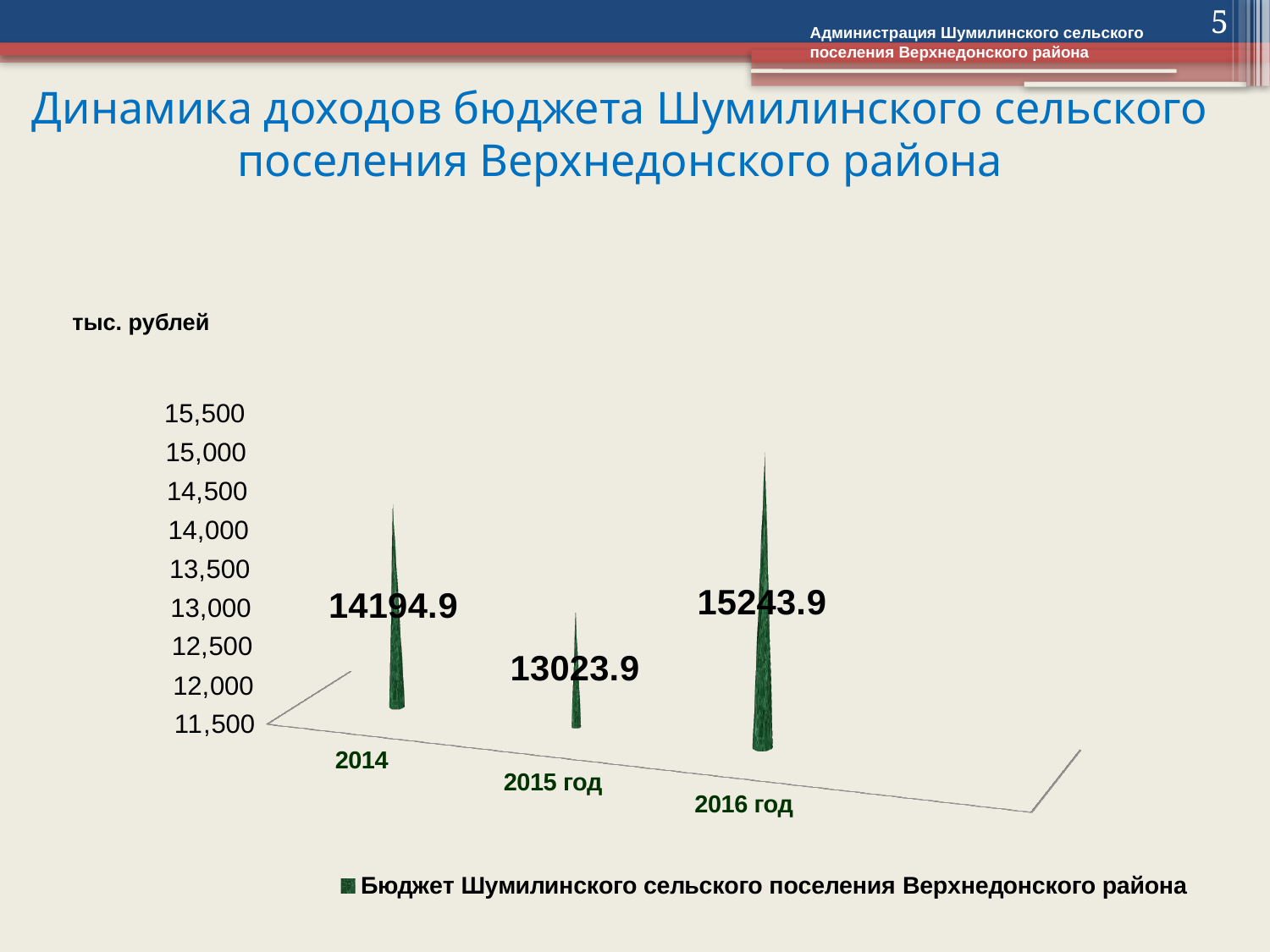
How many years are shown on the chart? 3 What unit is stated for the values on the chart? тыс. рублей What is the value for 2015 год? 13023.9 Which year has the lowest value? 2015 год What is the value for 2014? 14194.9 What is the difference between the values for 2014 and 2015 год? 1171.0 What is the value for 2016 год? 15243.9 How many series does the legend list? 1 Which is larger, the value for 2014 or the value for 2015 год? 2014 Which year has the highest value? 2016 год Is the value for 2016 год greater or less than 15,000? greater What is the difference between the values for 2016 год and 2014? 1049.0